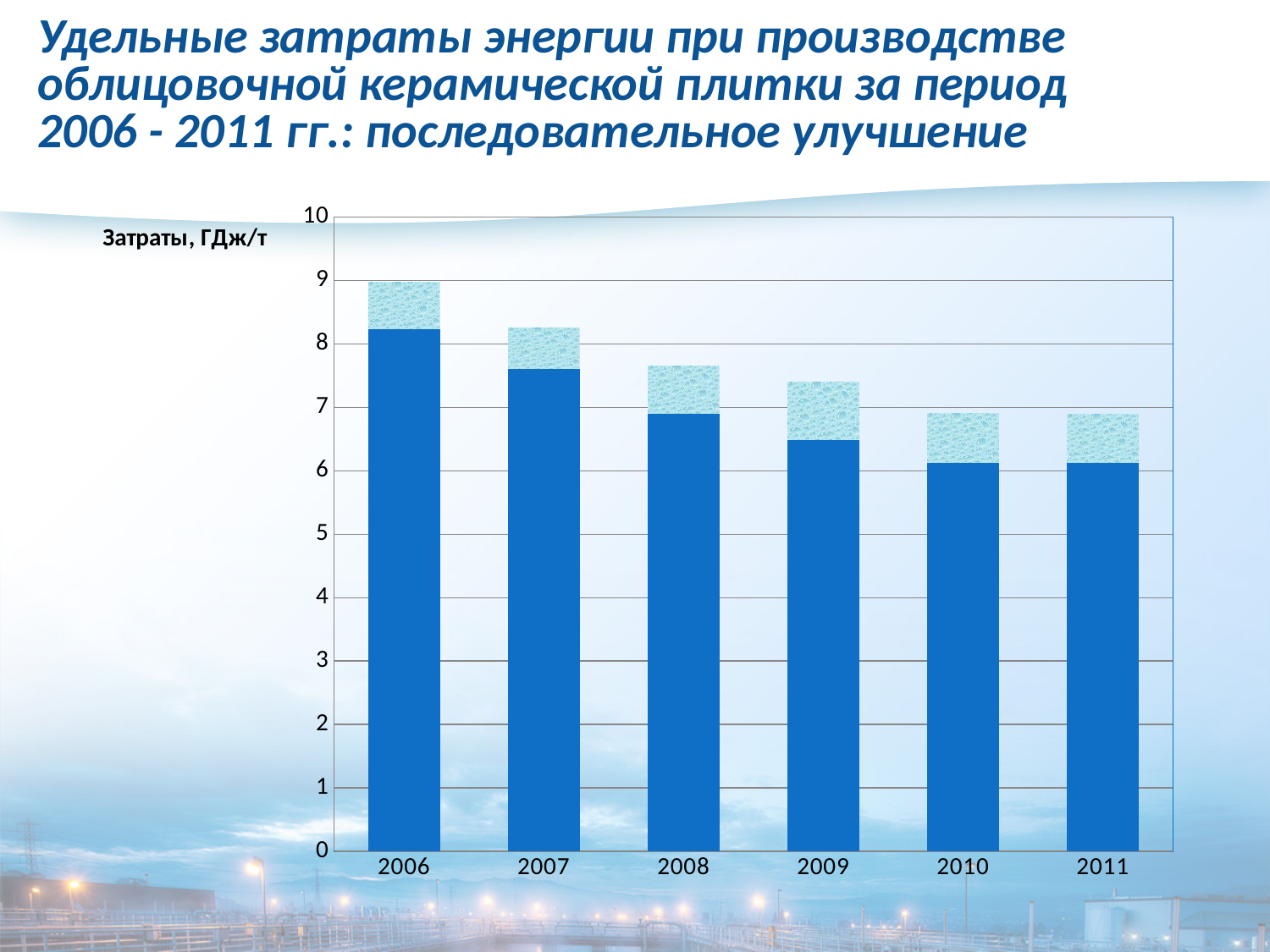
Is the total value for 2010 greater or less than 6? greater What label is shown for the vertical axis of the chart? Затраты, ГДж/т Which is larger, the total bar for 2006 or the total bar for 2011? 2006 Is the total value for 2009 greater or less than 8? less Which year has the highest total bar in the chart? 2006 Is the total value for 2006 greater or less than 8? greater Which is larger, the total bar for 2007 or the total bar for 2008? 2007 Do the total bar heights rise or fall from 2006 to 2011? fall What kind of chart is shown on the slide? bar chart How many years (categories) are shown on the x axis of the chart? 6